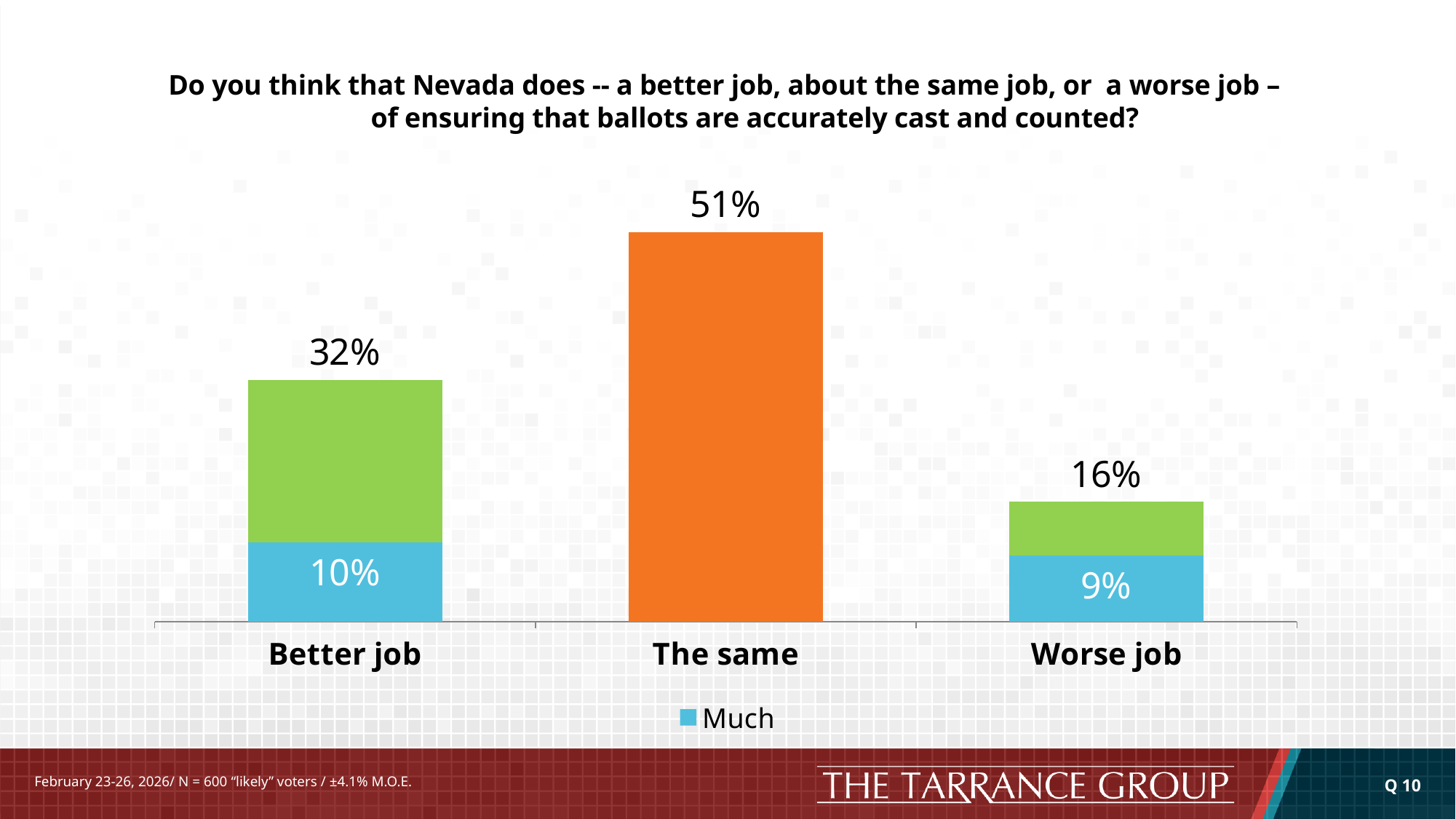
Which category has the lowest total value? Worse job What is the difference between the total for "Better job" and the total for "Worse job"? 16% What is the "Much" value for "Worse job"? 9% What kind of chart is shown on the slide? Bar chart What is the total value shown above the "Worse job" bar? 16% What is the total value shown above the "Better job" bar? 32% How many categories are shown on the x axis? 3 Which is larger, the "Much" value for "Better job" or the "Much" value for "Worse job"? Better job What is the "Much" value for "Better job"? 10% What is the difference between the total for "The same" and the total for "Better job"? 19% Which category has the highest total value? The same What is the total value shown for "The same"? 51%